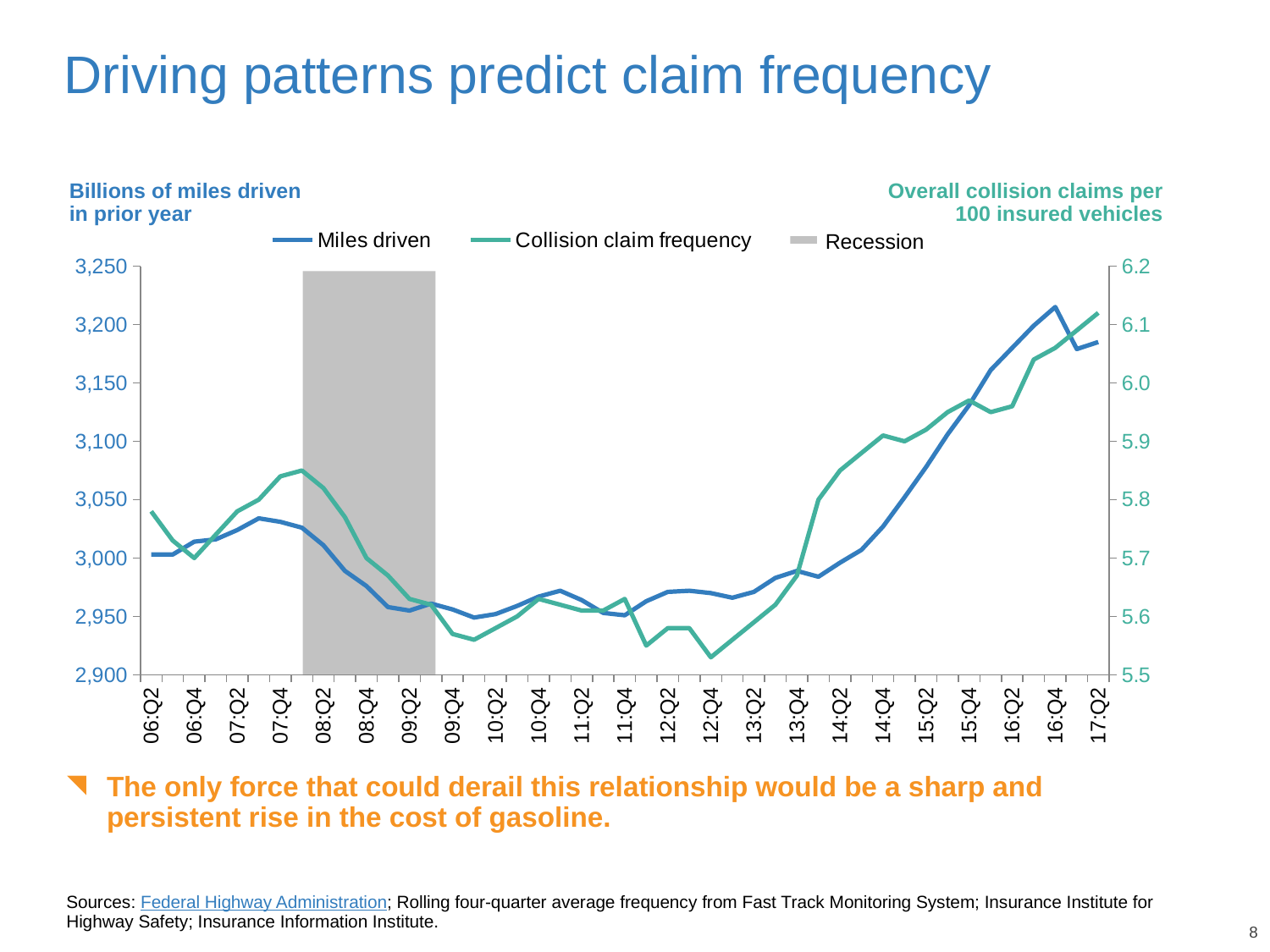
How many entries does the chart legend list? 3 Is the value for Miles driven at 16:Q4 greater or less than 3,200? greater What kind of chart is shown on the slide? line chart Is the value for Miles driven at 09:Q2 greater or less than 3,000? less Is the value for Collision claim frequency at 07:Q4 greater or less than 5.8? greater Does the Miles driven line rise or fall between 13:Q4 and 16:Q4? rise How many labels are shown on the x axis? 23 What is the title of the left vertical axis? Billions of miles driven in prior year At which x-axis label does the Collision claim frequency line reach its lowest point? 12:Q4 Which series is drawn in blue? Miles driven